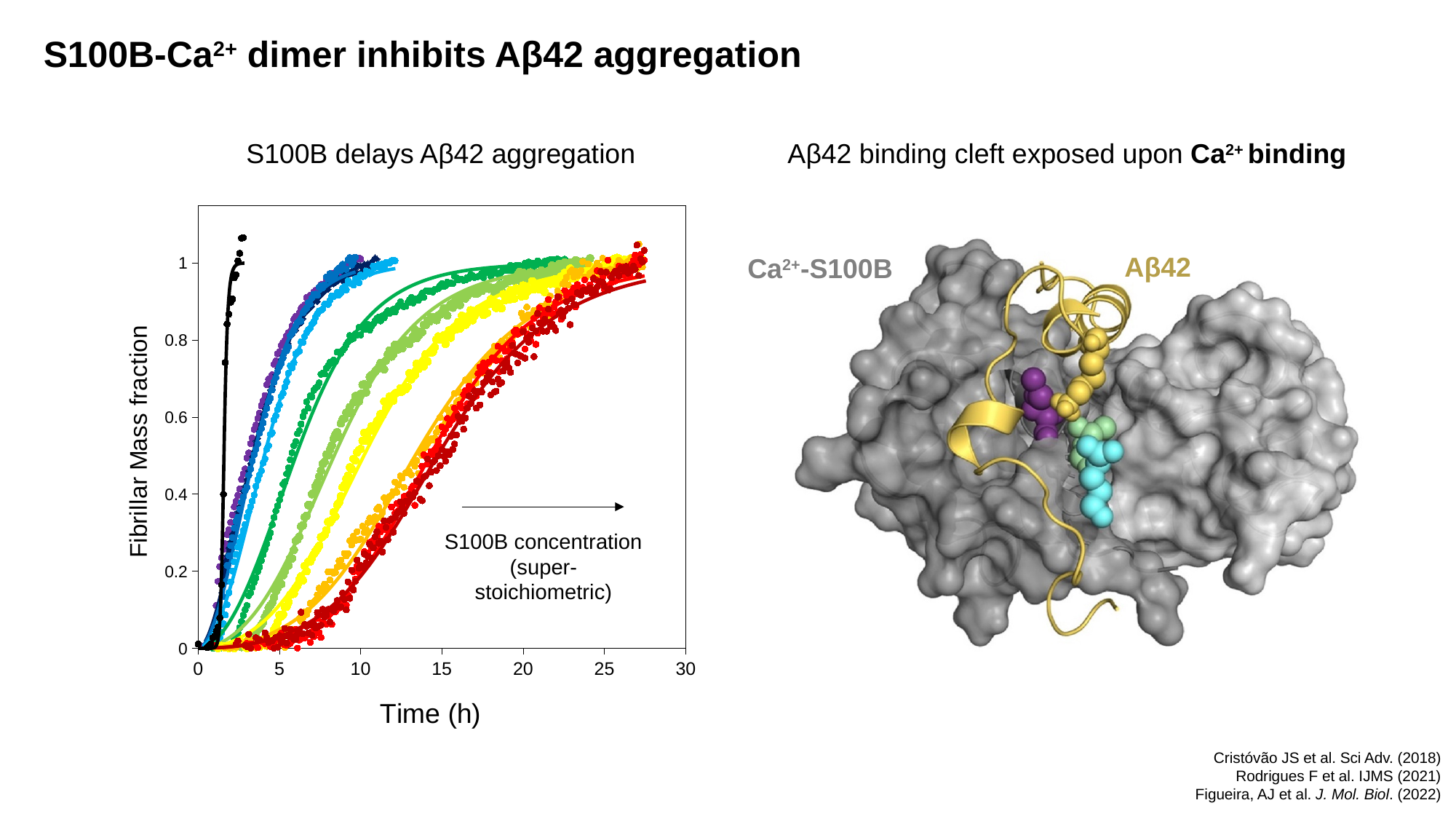
Is the value of the dark green series at 10 h greater or less than 0.6? greater Which series reaches a fibrillar mass fraction of 1 earliest? black Is the value of the orange series at 20 h greater or less than 0.6? greater What is the label of the y axis of the chart? Fibrillar Mass fraction Is the value of the black series at 2 h greater or less than 0.6? greater At 10 h, which series has the higher fibrillar mass fraction, the blue series or the red series? blue What kind of chart is shown on the slide? scatter plot What is the highest tick value shown on the x axis? 30 Which series takes the longest to reach a fibrillar mass fraction of 1? red What is the title of the chart? S100B delays Aβ42 aggregation Do the plotted values rise or fall as time increases along the x axis? rise